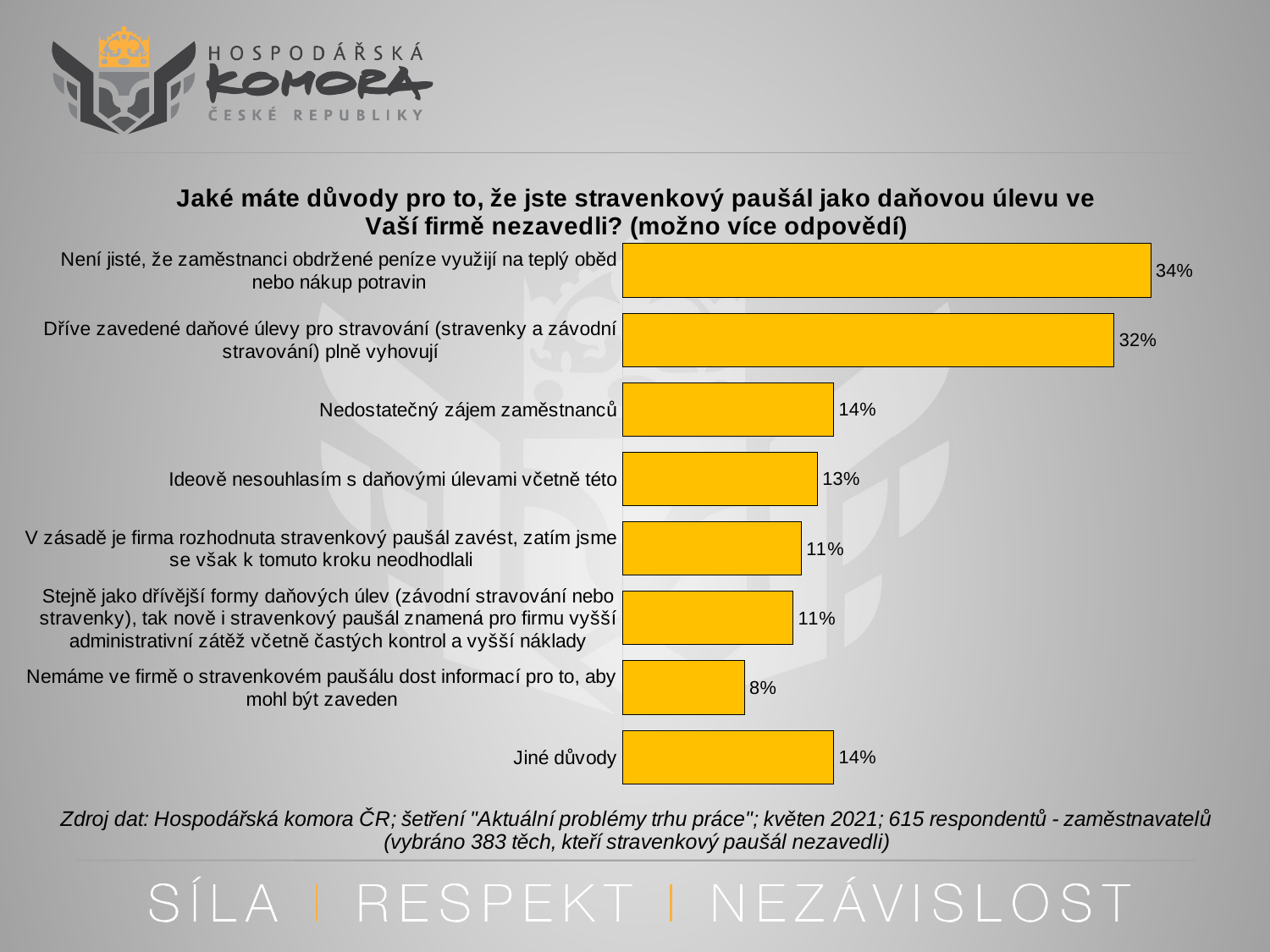
What is the difference between "Nedostatečný zájem zaměstnanců" and "Nemáme ve firmě o stravenkovém paušálu dost informací pro to, aby mohl být zaveden"? 6 percentage points What is the value for "Nedostatečný zájem zaměstnanců"? 14% Which is larger: the value for "Nedostatečný zájem zaměstnanců" or for "Ideově nesouhlasím s daňovými úlevami včetně této"? Nedostatečný zájem zaměstnanců Which reason has the lowest percentage? Nemáme ve firmě o stravenkovém paušálu dost informací pro to, aby mohl být zaveden Which reason has the highest percentage? Není jisté, že zaměstnanci obdržené peníze využijí na teplý oběd nebo nákup potravin What value is shown for "Nemáme ve firmě o stravenkovém paušálu dost informací pro to, aby mohl být zaveden"? 8% What kind of chart is shown on the slide? Bar chart What colour are the bars in the chart? Yellow/orange How many reasons (categories) are shown in the chart? 8 What is the value for "Ideově nesouhlasím s daňovými úlevami včetně této"? 13% What is the difference in percentage points between the top reason (34%) and "Dříve zavedené daňové úlevy pro stravování (stravenky a závodní stravování) plně vyhovují"? 2 percentage points What percentage is shown for "Jiné důvody"? 14%